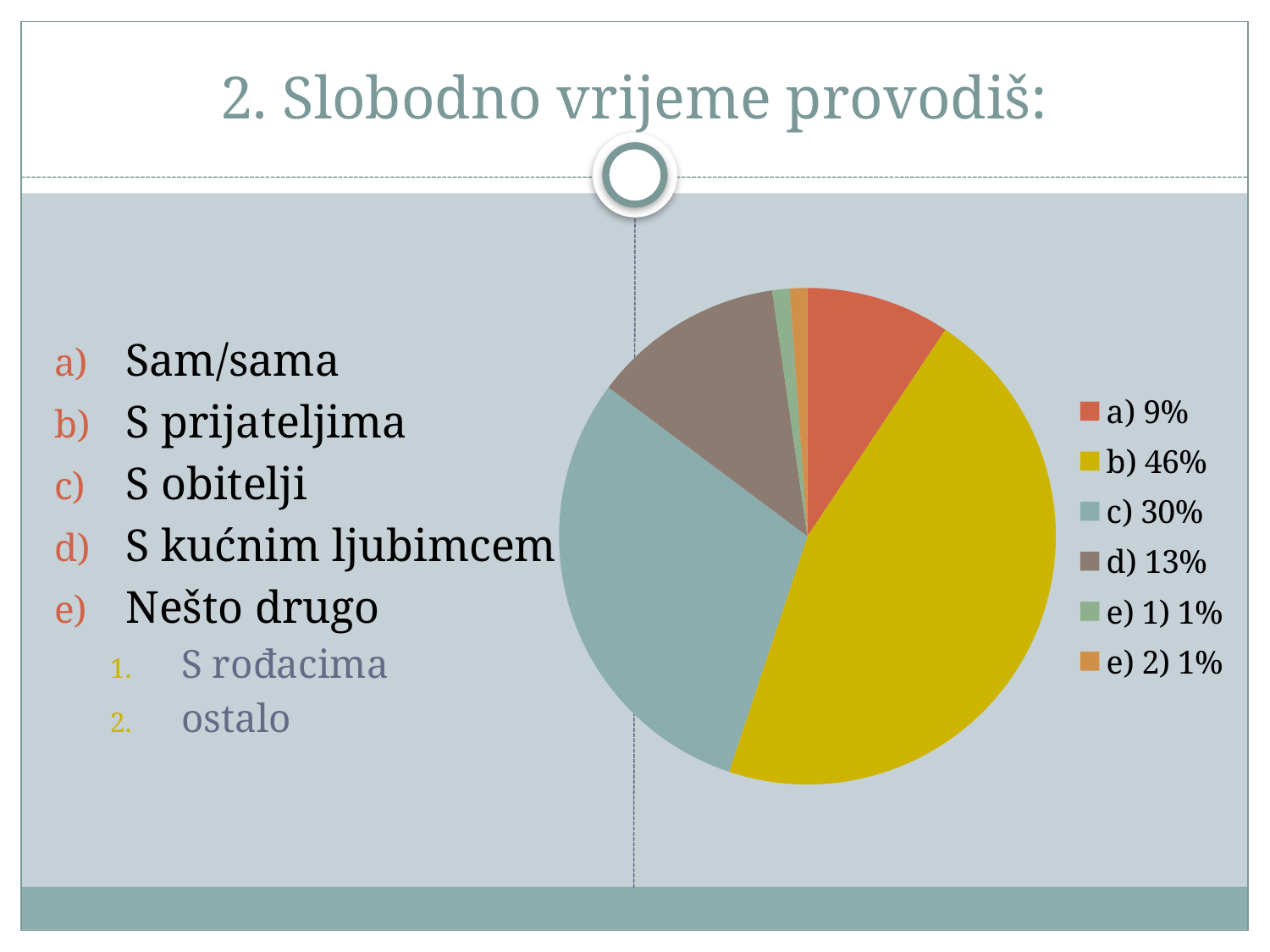
What share of the pie does category e) 1) take? 1% What kind of chart is shown on the slide? pie chart What percentage does the legend give for category c)? 30% How many slices does the pie chart have? 6 Which is larger, the slice for category c) or the slice for category d)? c) How many entries does the legend list? 6 What percentage does the legend give for category d)? 13% What colour is the slice for category b) in the pie chart? yellow Which category has the largest slice of the pie? b) What percentage does the legend give for category a)? 9% What percentage does the legend give for category b)? 46% What is the difference in percentage points between category b) and category c)? 16%